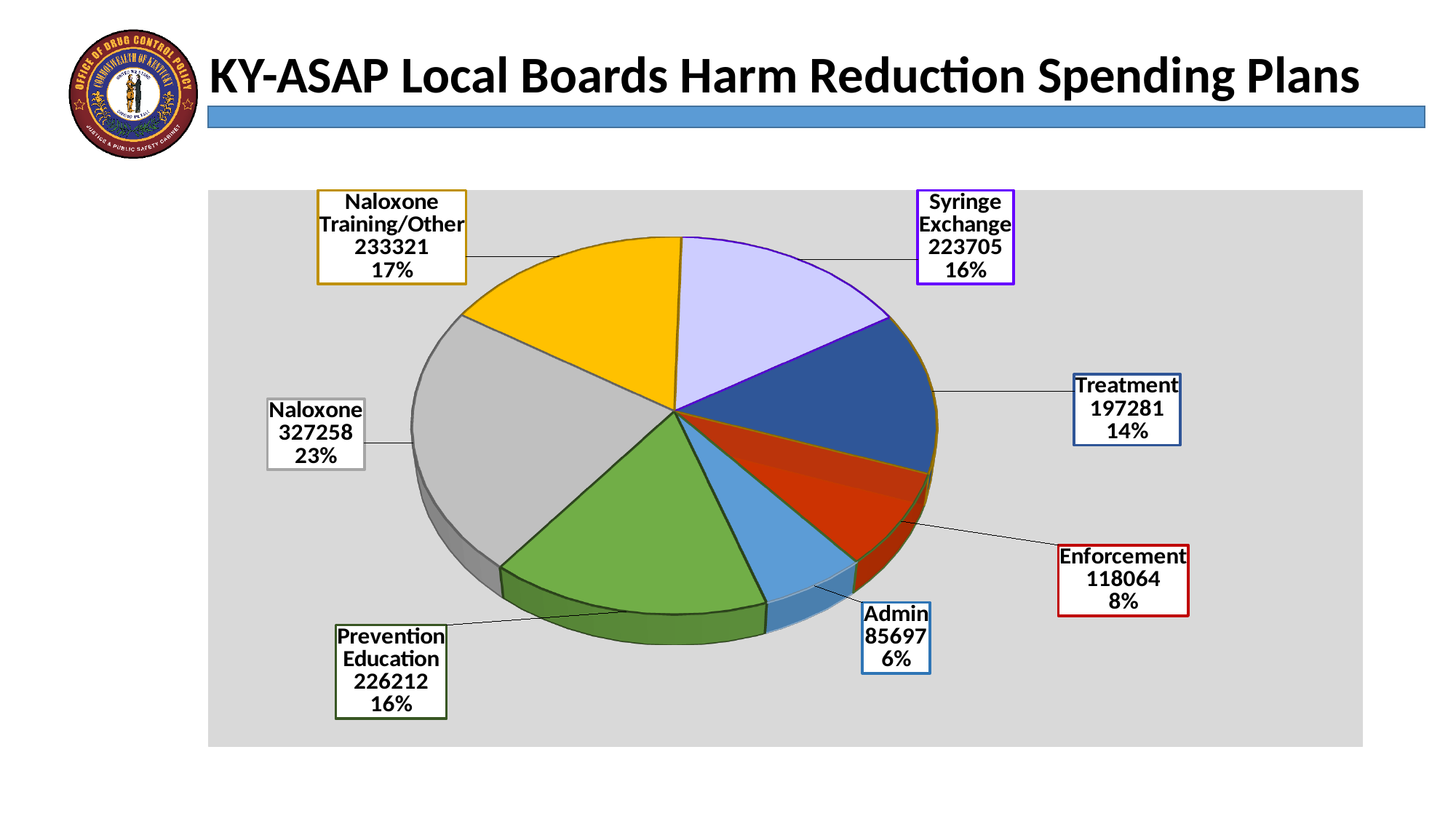
Which category has the smallest value? Admin Which is larger, Naloxone Training/Other or Prevention Education? Naloxone Training/Other Which category has the largest value? Naloxone What percentage share does Syringe Exchange have? 16% What percentage share does Admin have? 6% How many slices does the pie chart have? 7 What is the title of the slide containing the chart? KY-ASAP Local Boards Harm Reduction Spending Plans What is the difference between the values for Enforcement and Admin? 32367 What is the value for Enforcement? 118064 What is the difference between the values for Naloxone and Treatment? 129977 What is the value for Naloxone? 327258 What type of chart is shown on the slide? pie chart